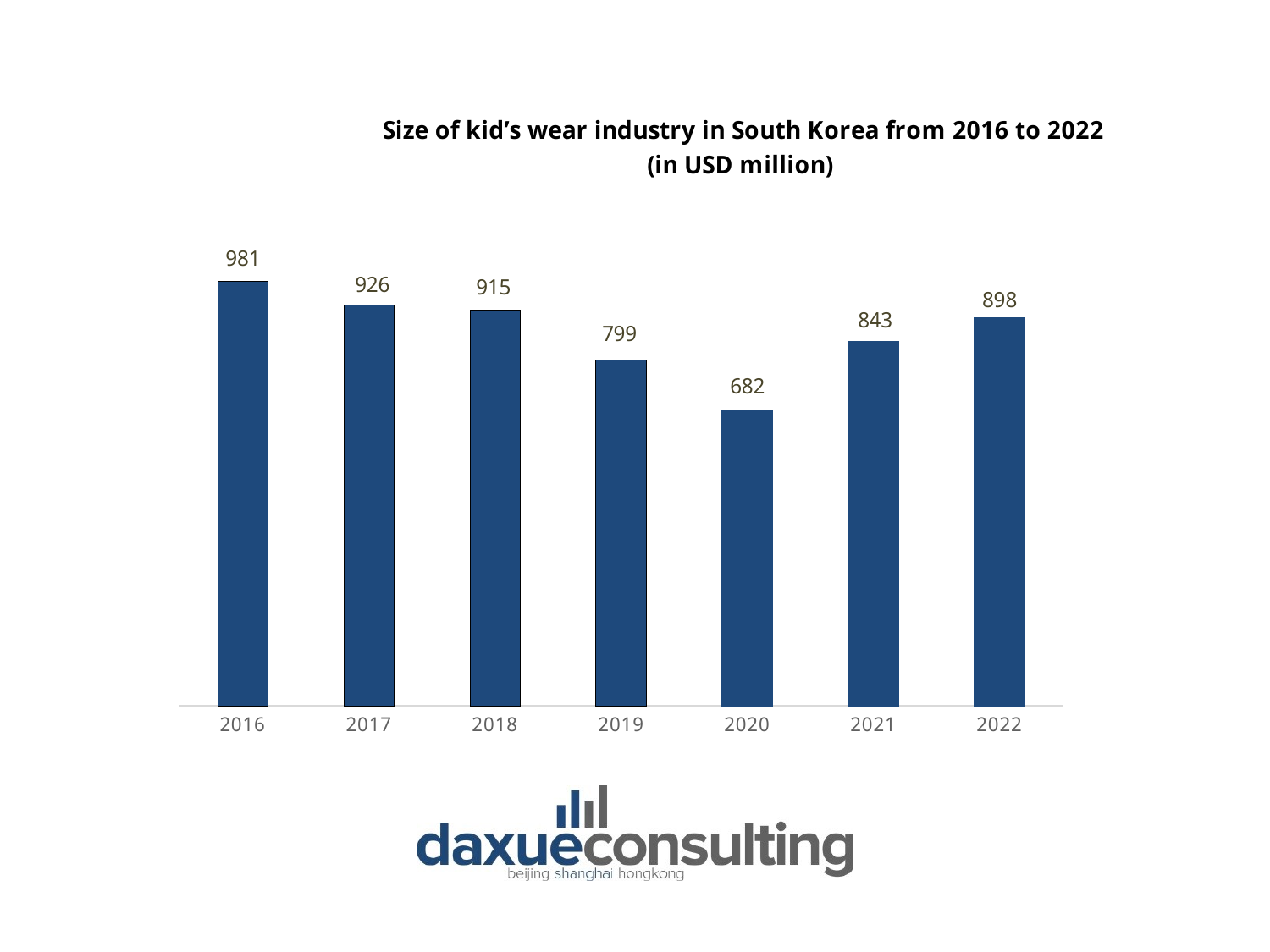
Which year has the lowest value? 2020 What value is shown for 2020? 682 In what unit are the values on the chart expressed? USD million What is the difference between the values for 2016 and 2020? 299 Which year has the highest value? 2016 How many years are shown on the chart? 7 What was the size of the kid's wear industry in South Korea in 2016? 981 What value is shown for 2022? 898 What is the difference between the values for 2021 and 2022? 55 What kind of chart is shown on the slide? Bar chart Which is larger, the value for 2017 or the value for 2022? 2017 Do the values rise or fall from 2016 to 2020? Fall